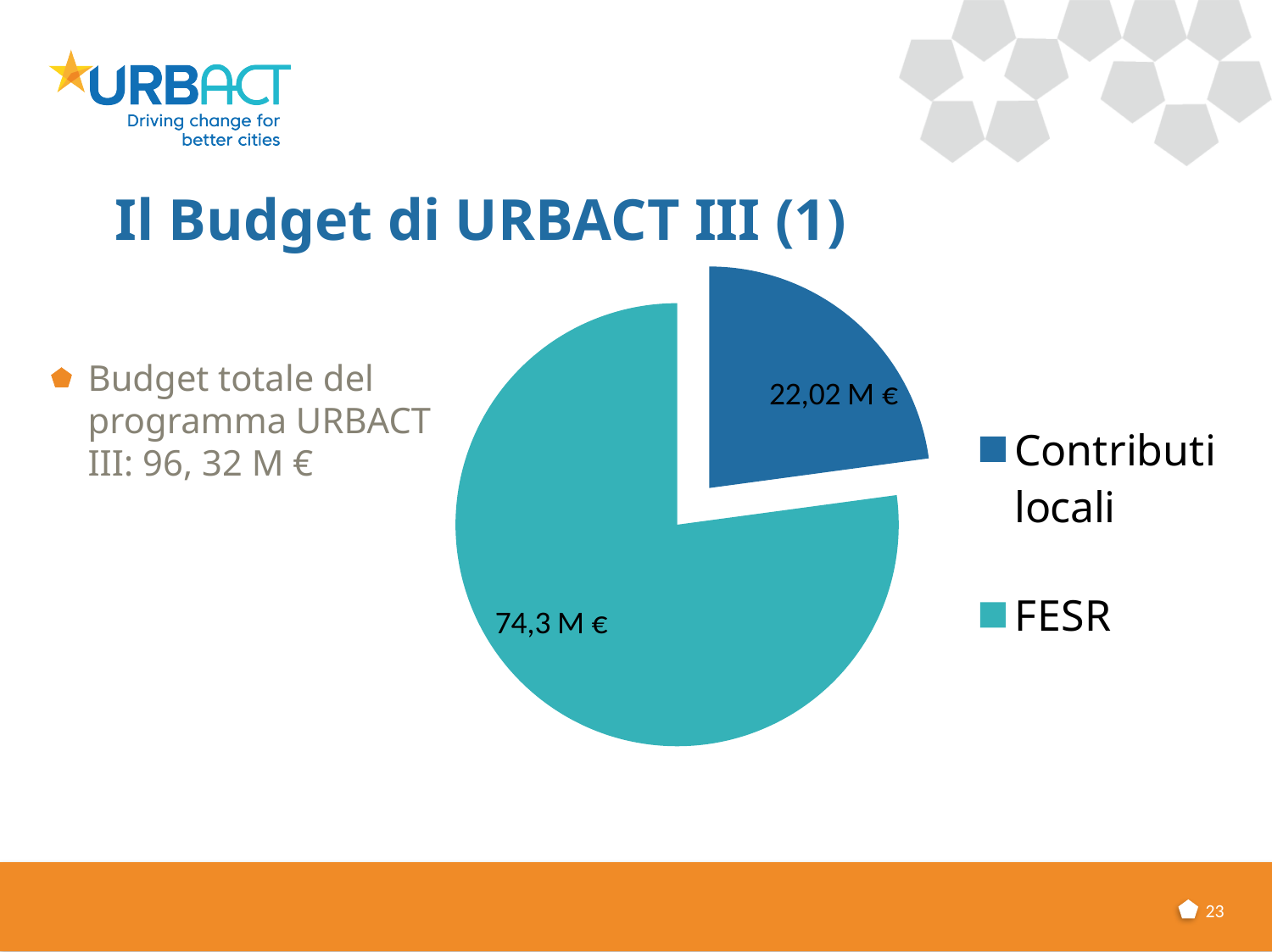
How many slices does the pie chart have? 2 What is the value of the Contributi locali slice? 22,02 M € Which slice of the pie is the smallest? Contributi locali Which slice of the pie is the largest? FESR What is the difference between the FESR value and the Contributi locali value? 52,28 M € What colour is the FESR slice? teal What is the total of the two slices in the pie chart? 96,32 M € What type of chart is shown on the slide? pie chart Which legend entry is shown in dark blue? Contributi locali How many entries does the legend list? 2 Which is larger, FESR or Contributi locali? FESR What is the value of the FESR slice? 74,3 M €